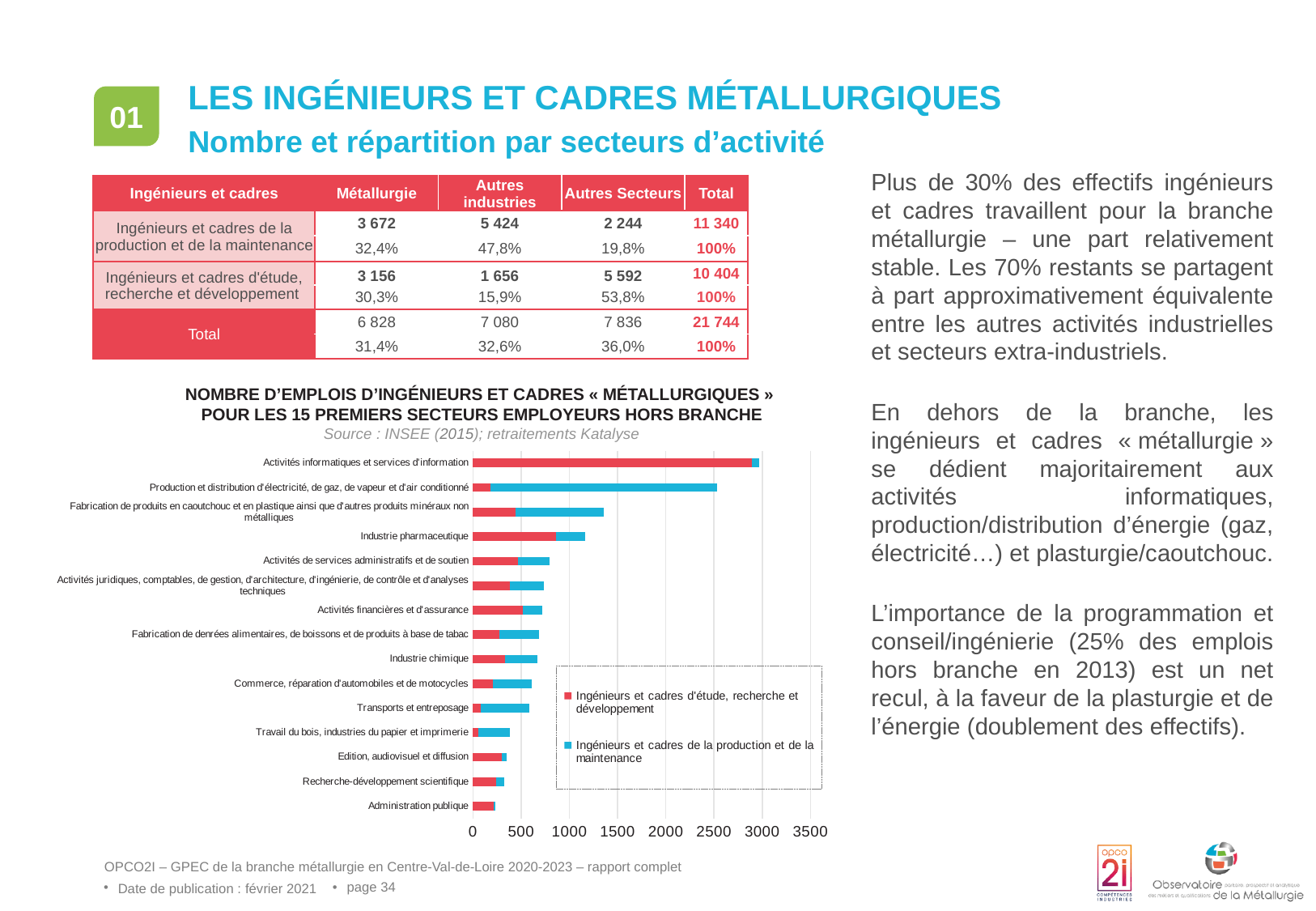
Is the total bar for Fabrication de produits en caoutchouc et en plastique ainsi que d'autres produits minéraux non métalliques greater or less than 1000? greater Is the total bar for Activités informatiques et services d'information greater or less than 2500? greater Is the total bar for Production et distribution d'électricité, de gaz, de vapeur et d'air conditionné greater or less than 2000? greater What is the source cited under the chart title? INSEE (2015); retraitements Katalyse Which sector has the shortest bar in the chart? Administration publique Which sector has the longer bar: Industrie pharmaceutique or Industrie chimique? Industrie pharmaceutique Which series is shown in blue in the chart legend? Ingénieurs et cadres de la production et de la maintenance How many series does the chart legend list? 2 Which sector has the longest bar in the chart? Activités informatiques et services d'information What kind of chart is shown on the slide? bar chart How many sectors (categories) are plotted in the bar chart? 15